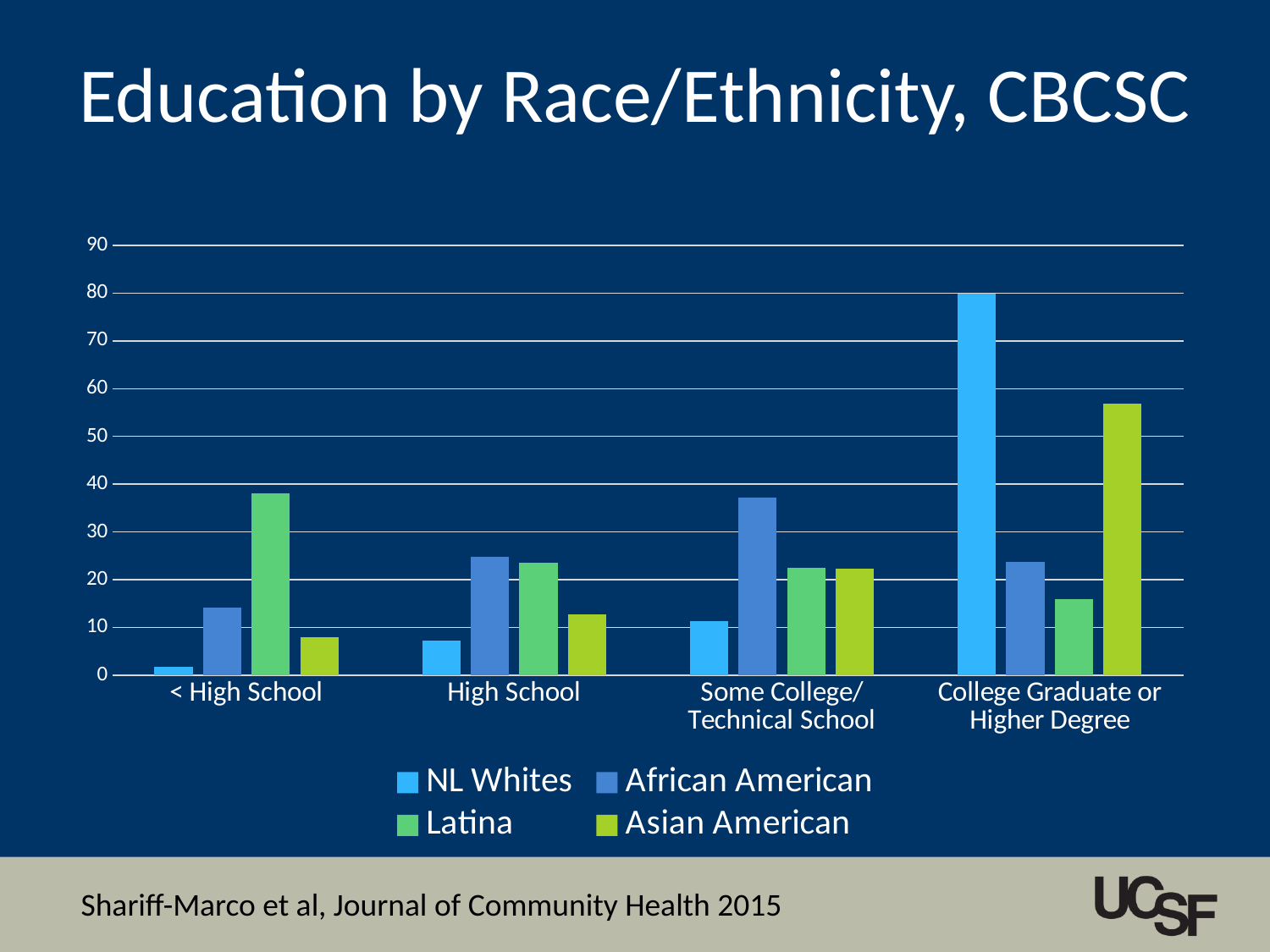
Is the value for NL Whites in the College Graduate or Higher Degree category greater or less than 70? greater Is the value for Latina in the < High School category greater or less than 30? greater Which group has the highest value in the < High School category? Latina How many education categories are shown on the x axis? 4 Which group has the lowest value in the College Graduate or Higher Degree category? Latina How many series does the legend list? 4 In the Some College/Technical School category, which is larger: African American or Latina? African American Which group has the highest value in the College Graduate or Higher Degree category? NL Whites Do the values for NL Whites rise or fall moving from < High School to College Graduate or Higher Degree? rise Is the value for NL Whites in the < High School category greater or less than 10? less Which group has the lowest value in the < High School category? NL Whites What kind of chart is shown on the slide? bar chart